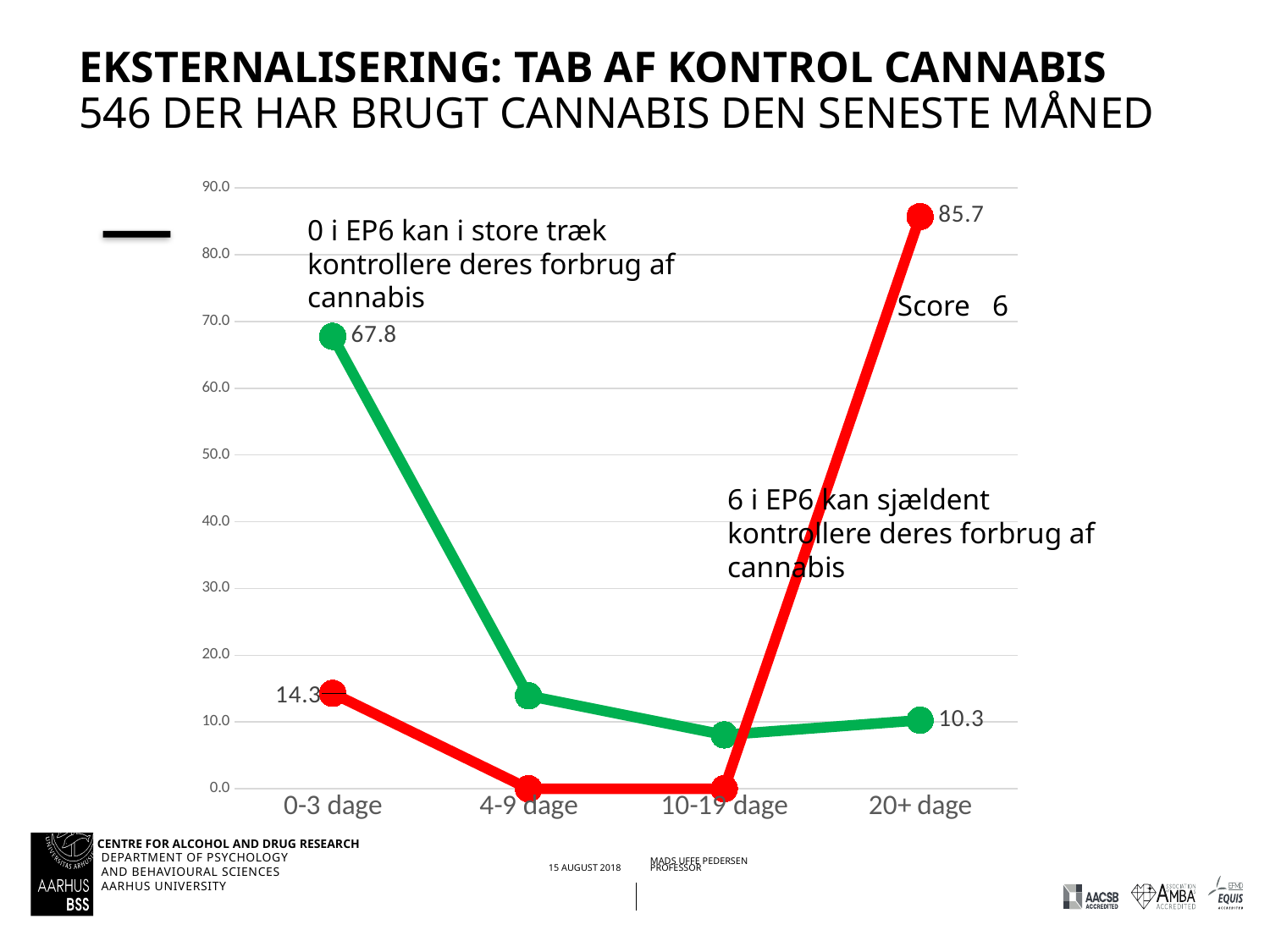
What kind of chart is shown on the slide? Line chart At 0-3 dage, which line has the larger value, the green line or the red line? Green line What is the value of the green line at 20+ dage? 10.3 At which category does the red line reach its highest value? 20+ dage How many categories are shown on the x axis? 4 What is the difference between the red line and the green line at 20+ dage? 75.4 Does the red line rise or fall from 10-19 dage to 20+ dage? Rises What is the value of the red line at 0-3 dage? 14.3 At which category does the green line reach its highest value? 0-3 dage What is the value of the red line at 20+ dage? 85.7 What is the value of the green line at 0-3 dage? 67.8 Is the value of the green line at 4-9 dage greater or less than 20.0? less